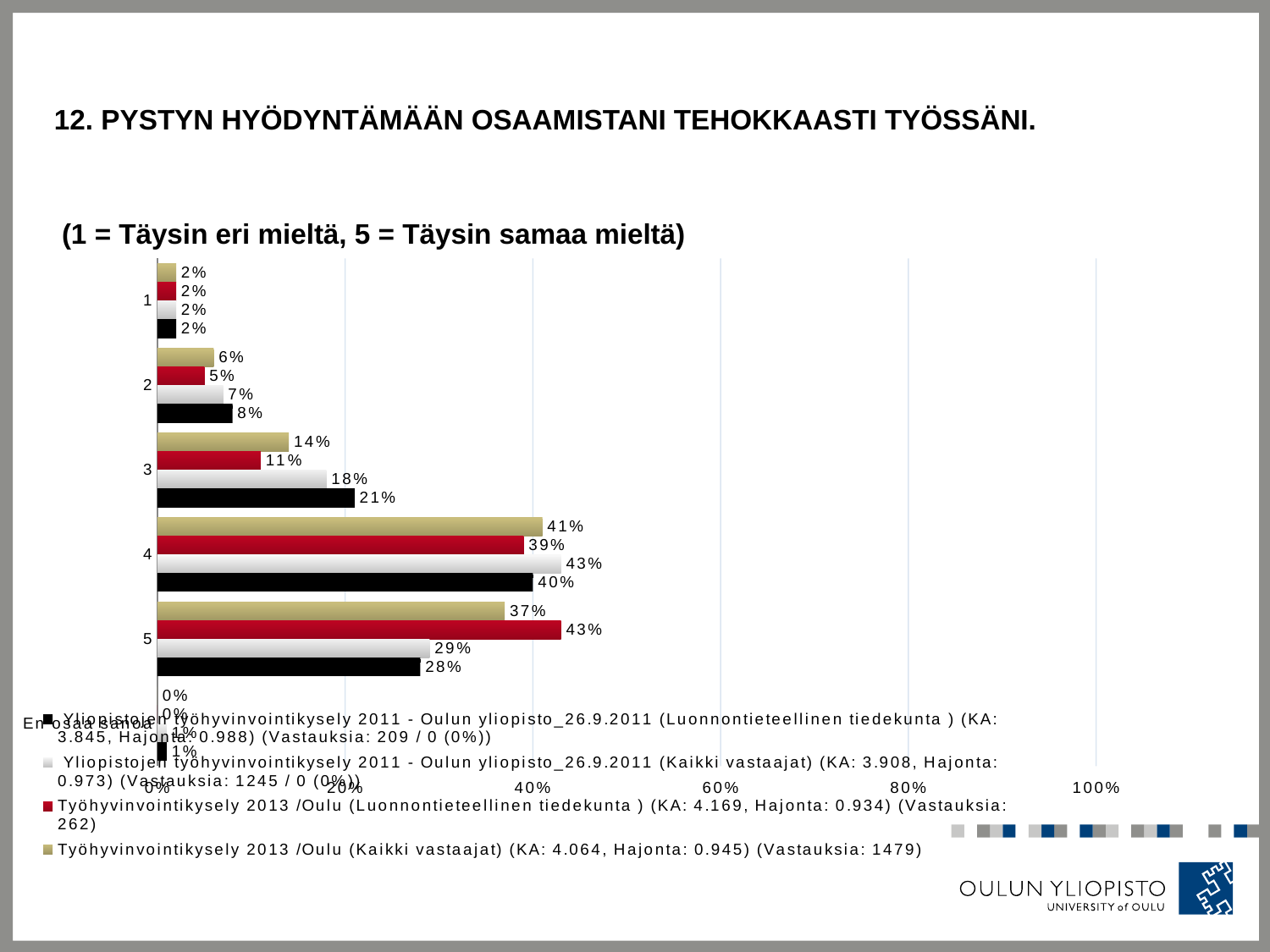
Which category has the highest value in the Työhyvinvointikysely 2013 /Oulu (Luonnontieteellinen tiedekunta) series? 5 For category 3, which series has the larger value: Yliopistojen työhyvinvointikysely 2011 (Luonnontieteellinen tiedekunta) or Työhyvinvointikysely 2013 /Oulu (Luonnontieteellinen tiedekunta)? Yliopistojen työhyvinvointikysely 2011 (Luonnontieteellinen tiedekunta) What is the value for category 4 in the Yliopistojen työhyvinvointikysely 2011 (Kaikki vastaajat) series? 43% What is the value for category 2 in the Yliopistojen työhyvinvointikysely 2011 (Luonnontieteellinen tiedekunta) series? 8% Which category has the highest value in the Työhyvinvointikysely 2013 /Oulu (Kaikki vastaajat) series? 4 What is the value for category 5 in the Työhyvinvointikysely 2013 /Oulu (Luonnontieteellinen tiedekunta) series? 43% How many series does the legend list? 4 What is the difference between the Työhyvinvointikysely 2013 /Oulu (Luonnontieteellinen tiedekunta) value and the Yliopistojen työhyvinvointikysely 2011 (Luonnontieteellinen tiedekunta) value for category 5? 15% What is the KA (mean) shown in the legend for the Työhyvinvointikysely 2013 /Oulu (Luonnontieteellinen tiedekunta) series? 4.169 What kind of chart is shown on the slide? bar chart Is the value for category 4 in the Työhyvinvointikysely 2013 /Oulu (Kaikki vastaajat) series greater or less than 20%? greater What is the value for category 3 in the Työhyvinvointikysely 2013 /Oulu (Kaikki vastaajat) series? 14%